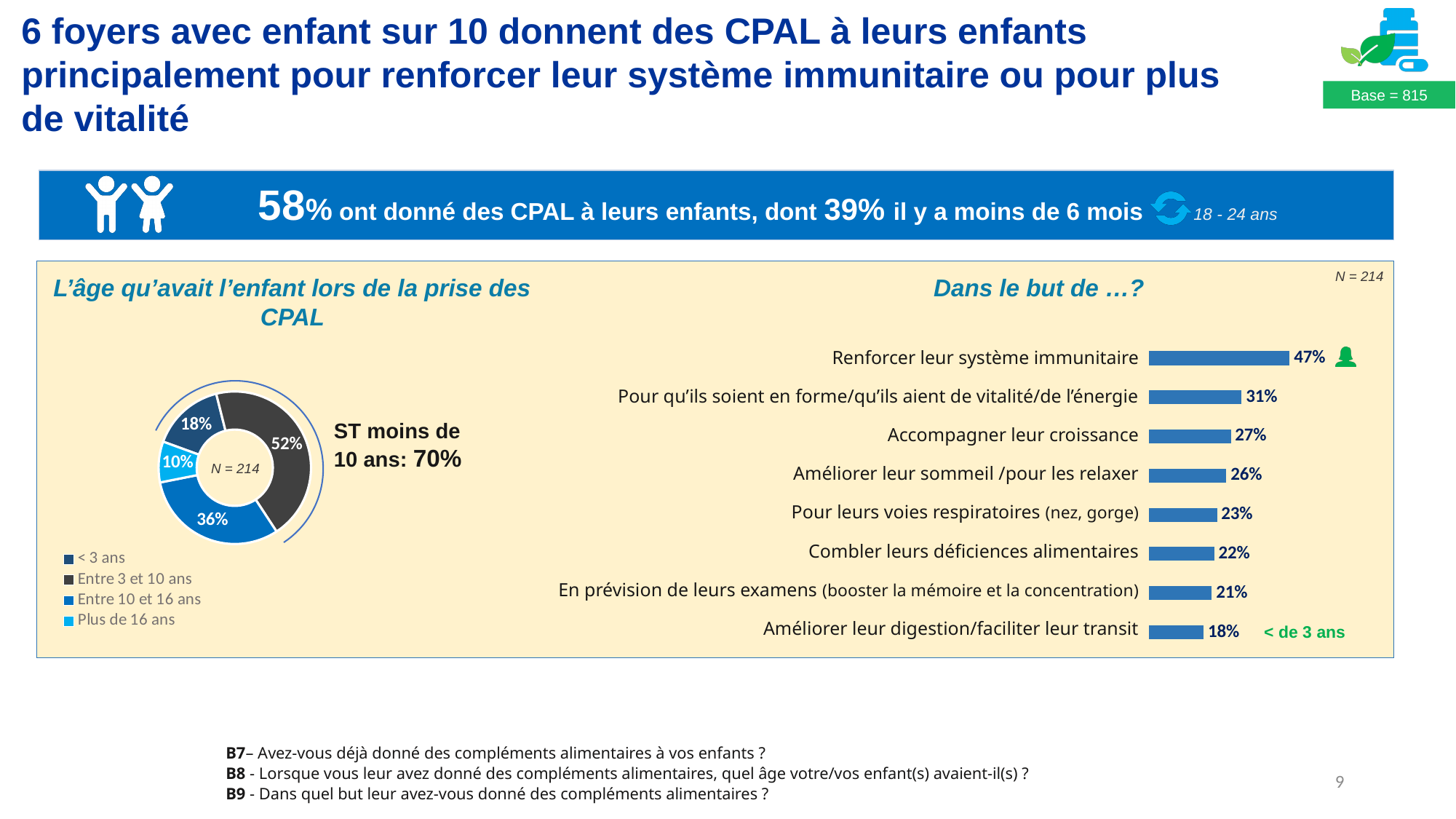
What kind of chart is 'Dans le but de …?'? Bar chart On the 'Dans le but de …?' chart, what is the difference between 'Renforcer leur système immunitaire' and 'Pour qu'ils soient en forme/qu'ils aient de vitalité/de l'énergie'? 16 percentage points On the 'Dans le but de …?' chart, what is the value for 'Accompagner leur croissance'? 27% How many entries does the legend of the 'L'âge qu'avait l'enfant lors de la prise des CPAL' chart list? 4 On the 'Dans le but de …?' chart, how many categories are shown? 8 On the 'L'âge qu'avait l'enfant lors de la prise des CPAL' chart, which is larger: '< 3 ans' or 'Entre 10 et 16 ans'? Entre 10 et 16 ans On the 'L'âge qu'avait l'enfant lors de la prise des CPAL' chart, what share is 'Plus de 16 ans'? 10% On the 'L'âge qu'avait l'enfant lors de la prise des CPAL' chart, what share is 'Entre 3 et 10 ans'? 52% On the 'Dans le but de …?' chart, which category has the highest value? Renforcer leur système immunitaire What kind of chart is 'L'âge qu'avait l'enfant lors de la prise des CPAL'? Donut (pie) chart On the 'Dans le but de …?' chart, which category has the lowest value? Améliorer leur digestion/faciliter leur transit On the 'Dans le but de …?' chart, what is the value for 'Renforcer leur système immunitaire'? 47%